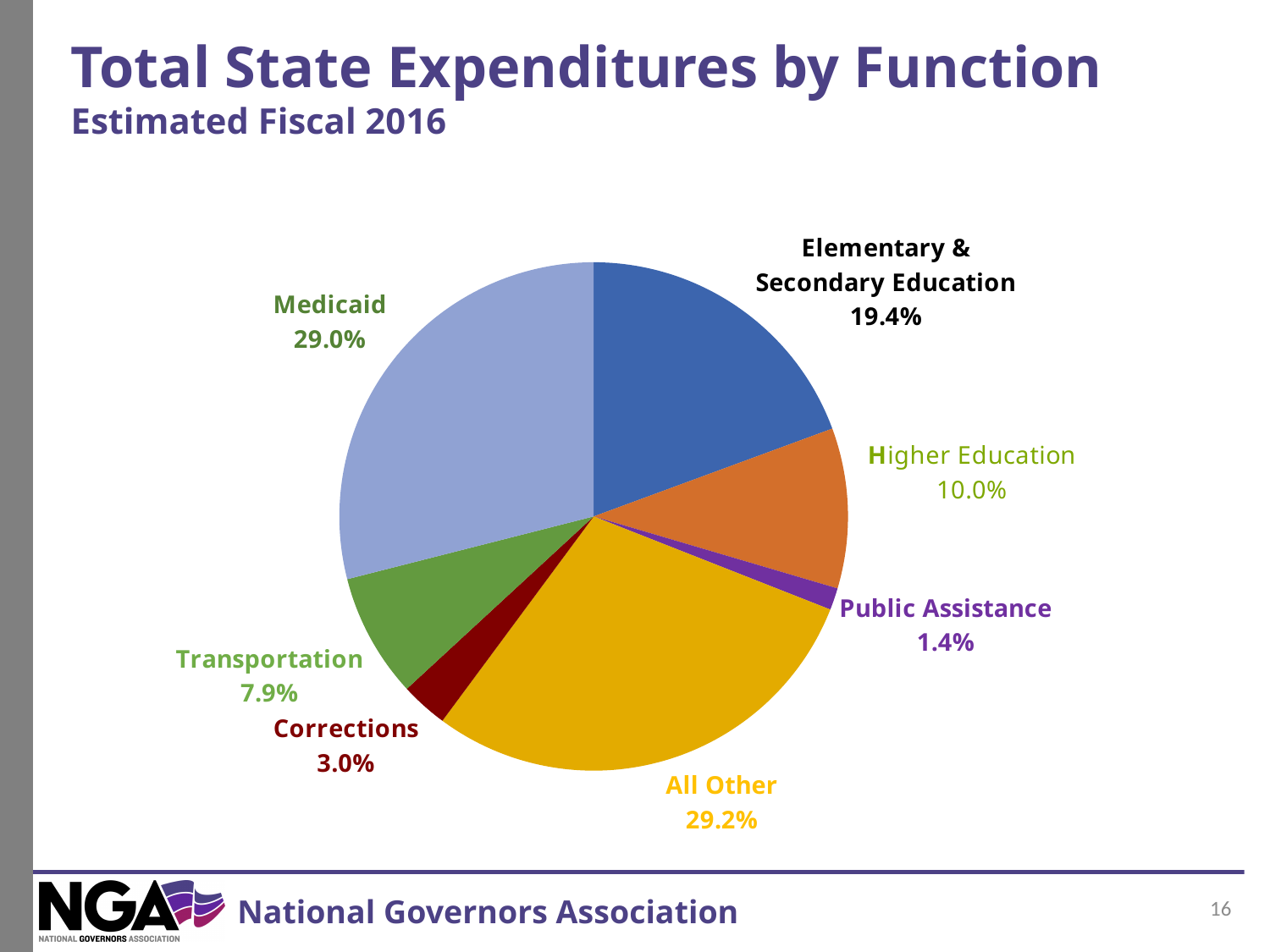
What percentage is shown for Elementary & Secondary Education? 19.4% How many percentage points larger is Elementary & Secondary Education than Higher Education? 9.4% What kind of chart is shown on the slide? Pie chart What percentage of expenditures is labelled Public Assistance? 1.4% What is the difference between the Medicaid share and the Transportation share? 21.1% Which function has the smallest share of expenditures? Public Assistance What fiscal year does the chart's subtitle refer to? Estimated Fiscal 2016 How many slices does the pie chart have? 7 Which function has the largest share of expenditures? All Other What is the value for Higher Education? 10.0% Which is larger, the share for Transportation or the share for Corrections? Transportation What share of total state expenditures goes to Medicaid? 29.0%